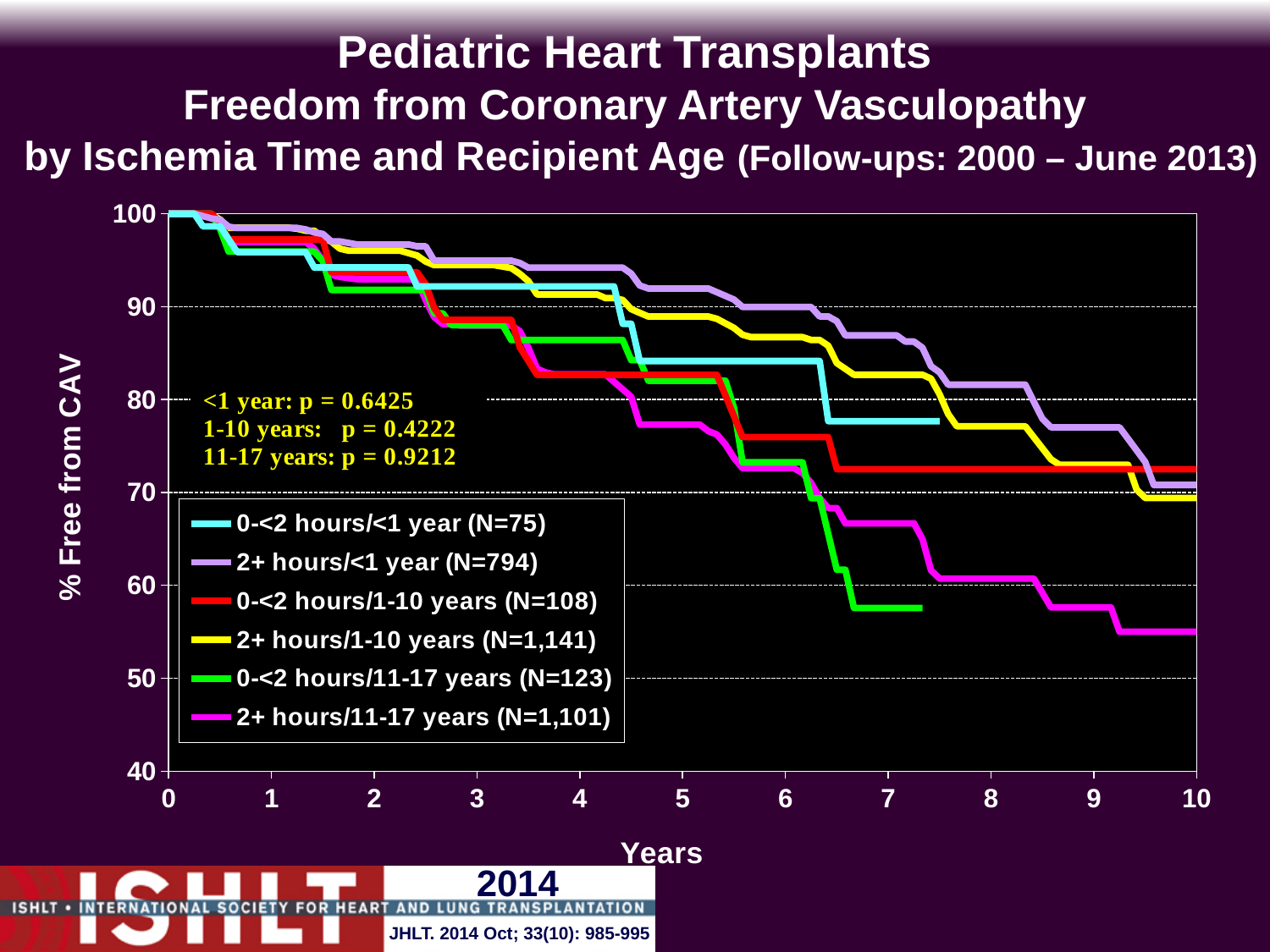
At year 6, which series has the larger value: 2+ hours/<1 year or 2+ hours/11-17 years? 2+ hours/<1 year Do the values for the series rise or fall as years increase along the x axis? fall Which series has the lowest % free from CAV at year 10? 2+ hours/11-17 years (N=1,101) What kind of chart is shown on the slide? line chart How many series does the legend list? 6 Is the value for 0-<2 hours/<1 year at year 7 greater or less than 80? less Is the value for 0-<2 hours/1-10 years at year 10 greater or less than 70? greater What is the label of the y axis? % Free from CAV Which series has the highest % free from CAV at year 5? 2+ hours/<1 year (N=794) Is the value for 2+ hours/11-17 years at year 10 greater or less than 60? less What is the p-value shown for the <1 year comparison? 0.6425